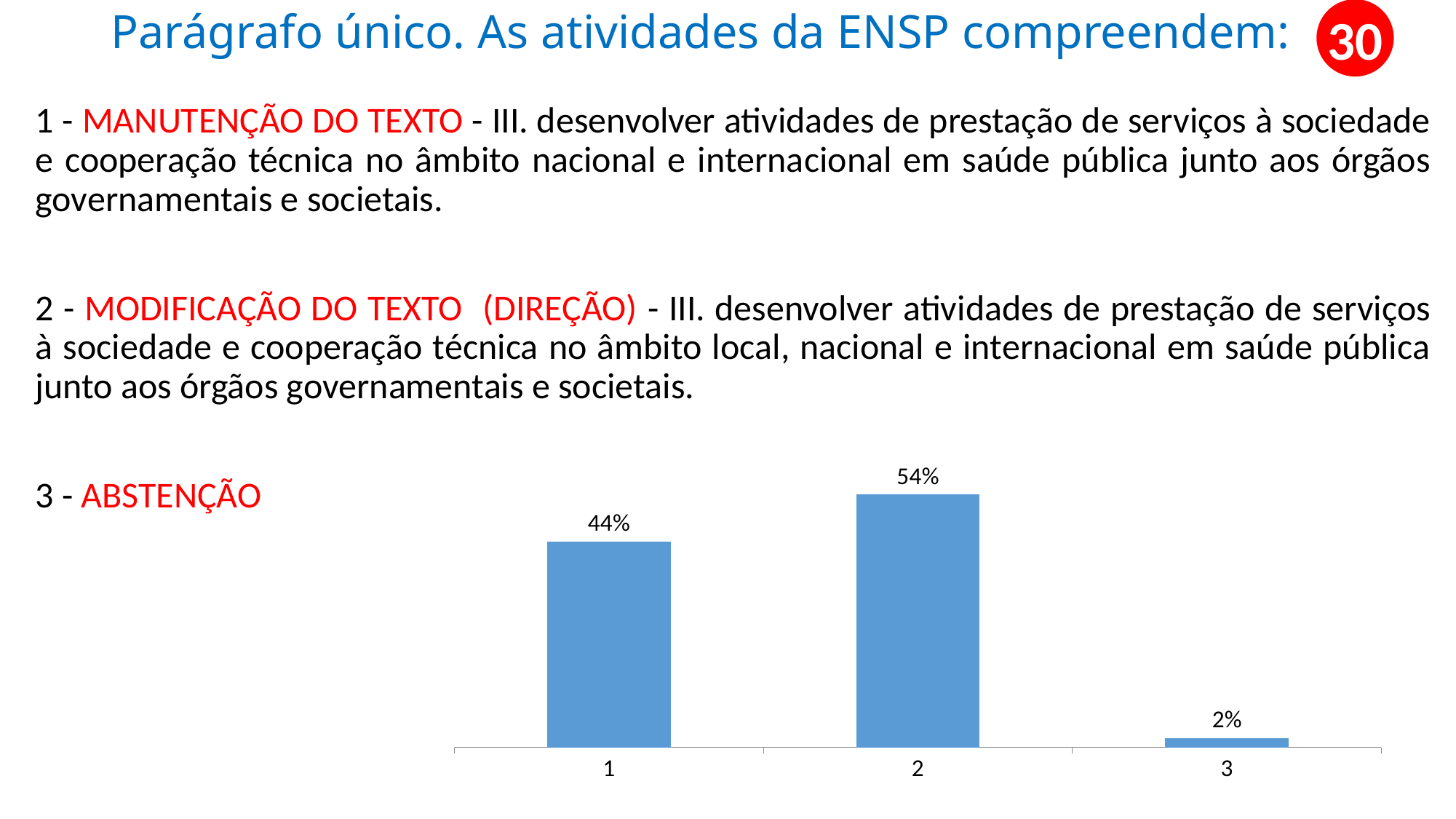
Which category has the lowest value in the bar chart? 3 What is the value shown for category 3 in the bar chart? 2% Which is larger, the value for category 1 or the value for category 2? category 2 What is the total of the three values shown in the bar chart? 100% What is the value shown for category 1 in the bar chart? 44% Which category has the highest value in the bar chart? 2 What is the value shown for category 2 in the bar chart? 54% How many categories are shown on the x axis of the bar chart? 3 What colour are the bars in the chart? blue What kind of chart is shown on the slide? bar chart What is the difference between the values for category 2 and category 1? 10% What is the difference between the values for category 1 and category 3? 42%